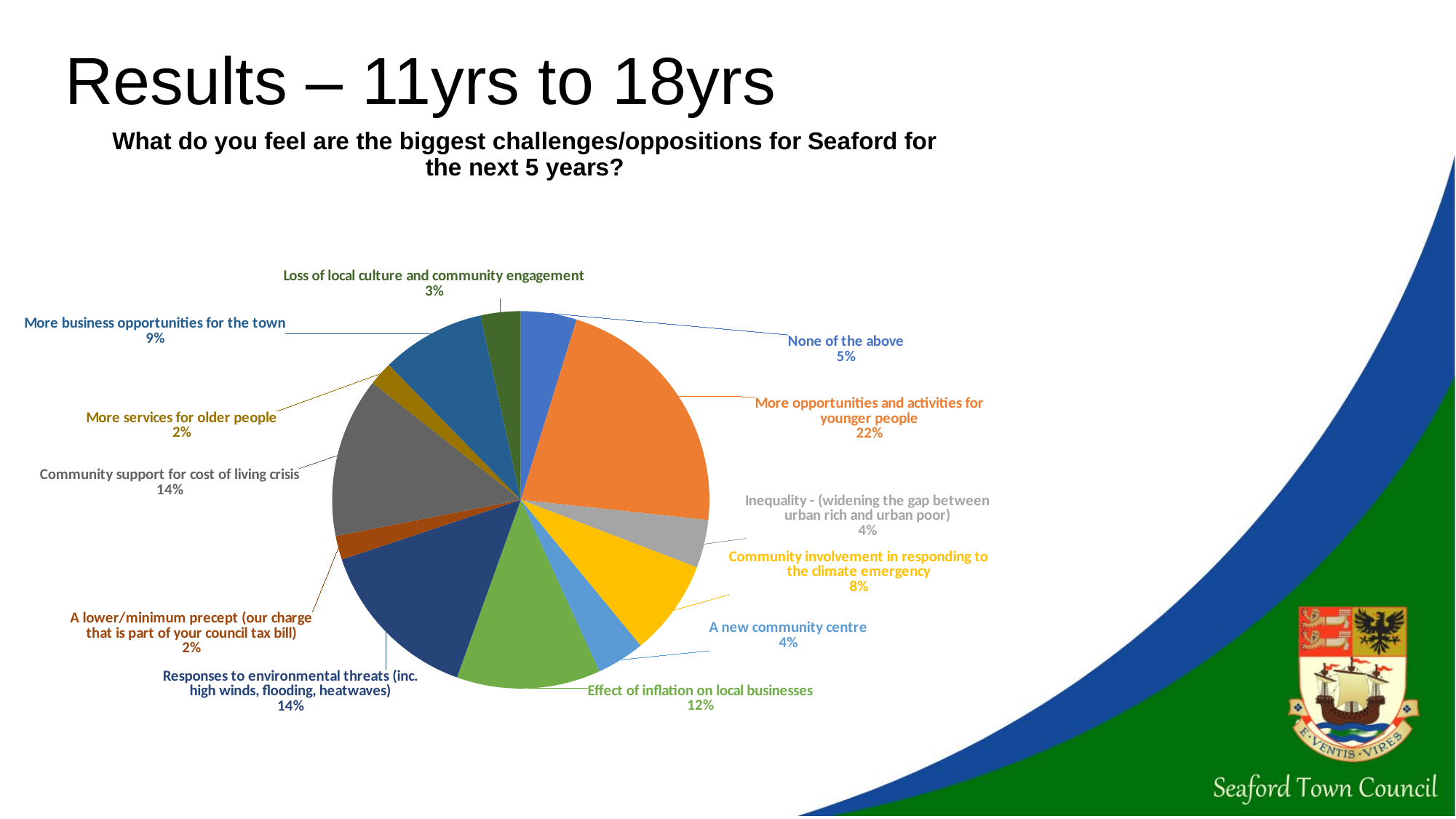
What kind of chart is shown on the slide? pie chart Which is larger: 'Responses to environmental threats' or 'More business opportunities for the town'? Responses to environmental threats What is the combined percentage of 'Community support for cost of living crisis' and 'Responses to environmental threats'? 28% What share is shown for 'Effect of inflation on local businesses'? 12% How many slices does the pie chart have? 12 What percentage is shown for 'None of the above'? 5% Which category has the largest slice of the pie? More opportunities and activities for younger people What is the difference in percentage points between 'More opportunities and activities for younger people' and 'Effect of inflation on local businesses'? 10 What percentage is shown for 'Community involvement in responding to the climate emergency'? 8% What survey question is the pie chart about? What do you feel are the biggest challenges/oppositions for Seaford for the next 5 years? What percentage is shown for 'More business opportunities for the town'? 9% What percentage of respondents chose 'More opportunities and activities for younger people'? 22%